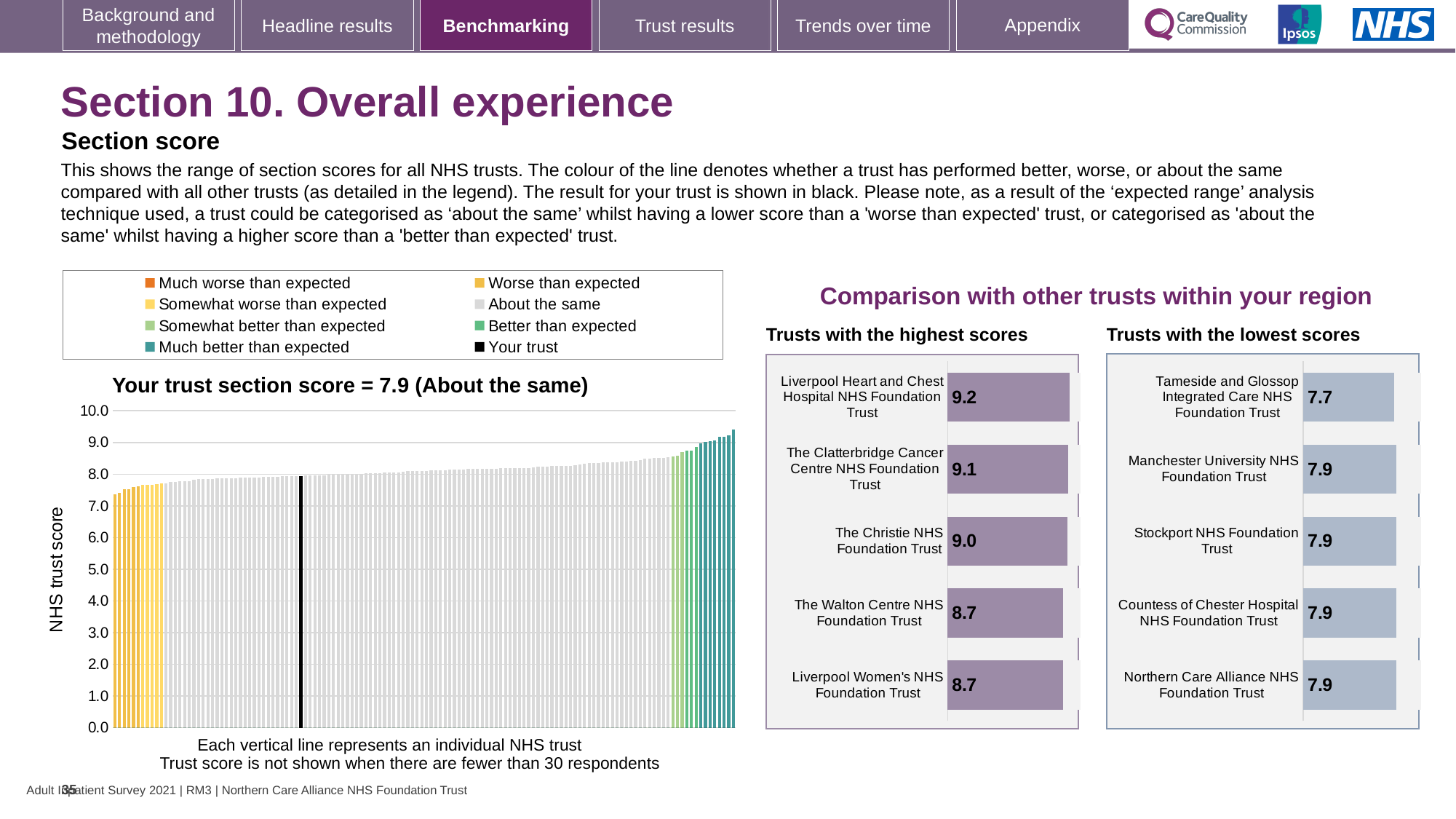
In the 'Your trust section score' chart, is the value of the tallest bar greater or less than 9.0? greater In the 'Trusts with the highest scores' chart, how many trusts are shown? 5 In the 'Trusts with the highest scores' chart, what is the difference between the scores of The Clatterbridge Cancer Centre NHS Foundation Trust and The Walton Centre NHS Foundation Trust? 0.4 In the 'Trusts with the lowest scores' chart, which trust has the lowest score? Tameside and Glossop Integrated Care NHS Foundation Trust In the 'Trusts with the highest scores' chart, what is the score for Liverpool Heart and Chest Hospital NHS Foundation Trust? 9.2 In the 'Trusts with the lowest scores' chart, which is larger: the score for Manchester University NHS Foundation Trust or Tameside and Glossop Integrated Care NHS Foundation Trust? Manchester University NHS Foundation Trust In the 'Trusts with the lowest scores' chart, what is the difference between the scores of Stockport NHS Foundation Trust and Tameside and Glossop Integrated Care NHS Foundation Trust? 0.2 In the 'Trusts with the lowest scores' chart, what is the score for Tameside and Glossop Integrated Care NHS Foundation Trust? 7.7 In the 'Trusts with the highest scores' chart, which trust has the highest score? Liverpool Heart and Chest Hospital NHS Foundation Trust In the 'Trusts with the highest scores' chart, what is the score for The Christie NHS Foundation Trust? 9.0 In the 'Your trust section score' chart, what is the section score for your trust? 7.9 In the 'Your trust section score' chart, do the bar values rise or fall from left to right? rise